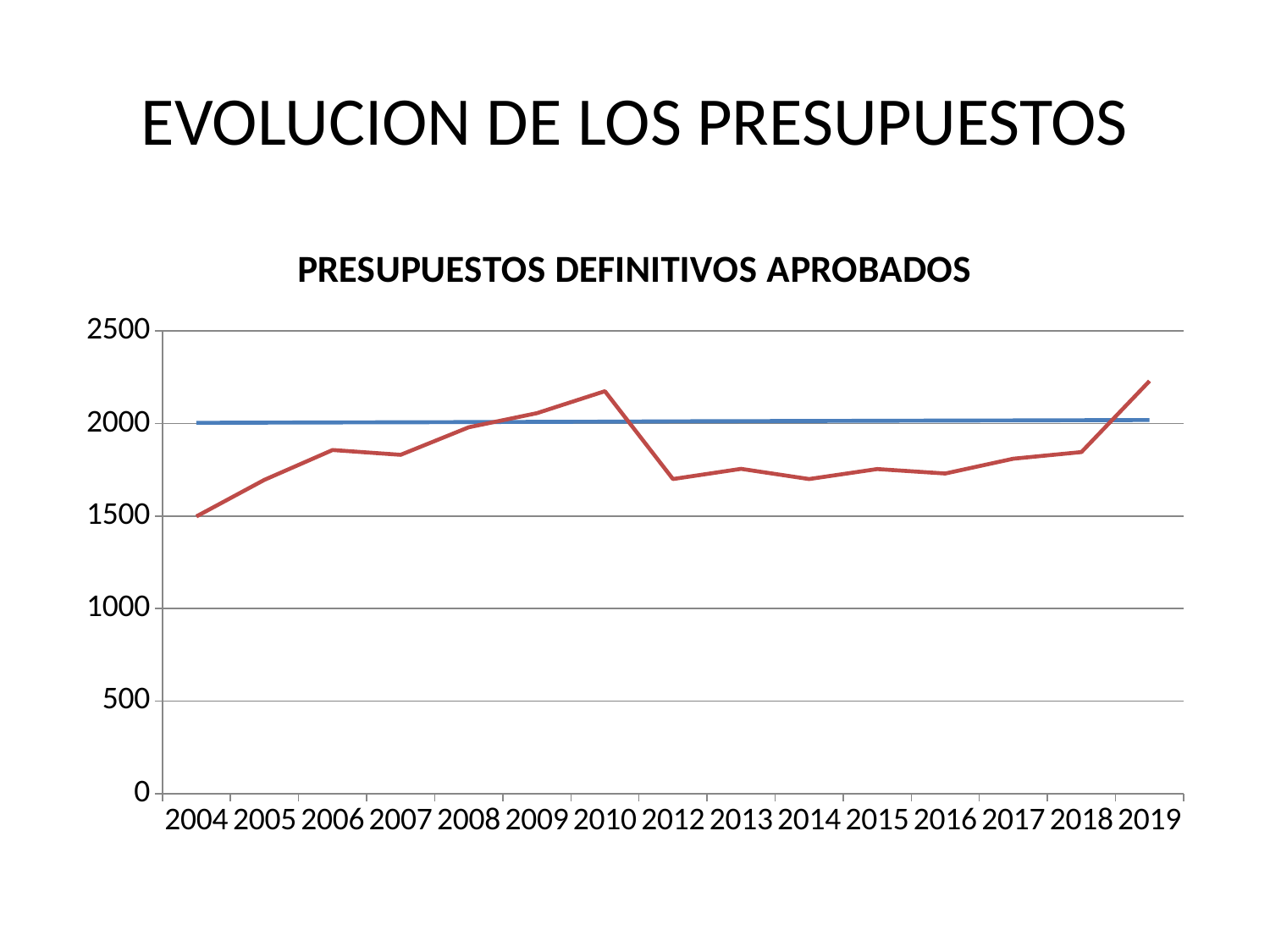
Is the value of the red line for 2010 greater or less than 2000? greater Is the value of the red line for 2006 greater or less than 2000? less Is the value of the red line for 2019 greater or less than 2000? greater Which year has the lowest value on the red line? 2004 What is the title of the chart? PRESUPUESTOS DEFINITIVOS APROBADOS Does the red line rise or fall between 2004 and 2010? Rise Which year has the larger value on the red line, 2004 or 2019? 2019 What type of chart is shown on the slide? Line chart How many lines are plotted on the chart? 2 How many years are shown on the x axis of the chart? 15 Which year has the larger value on the red line, 2010 or 2012? 2010